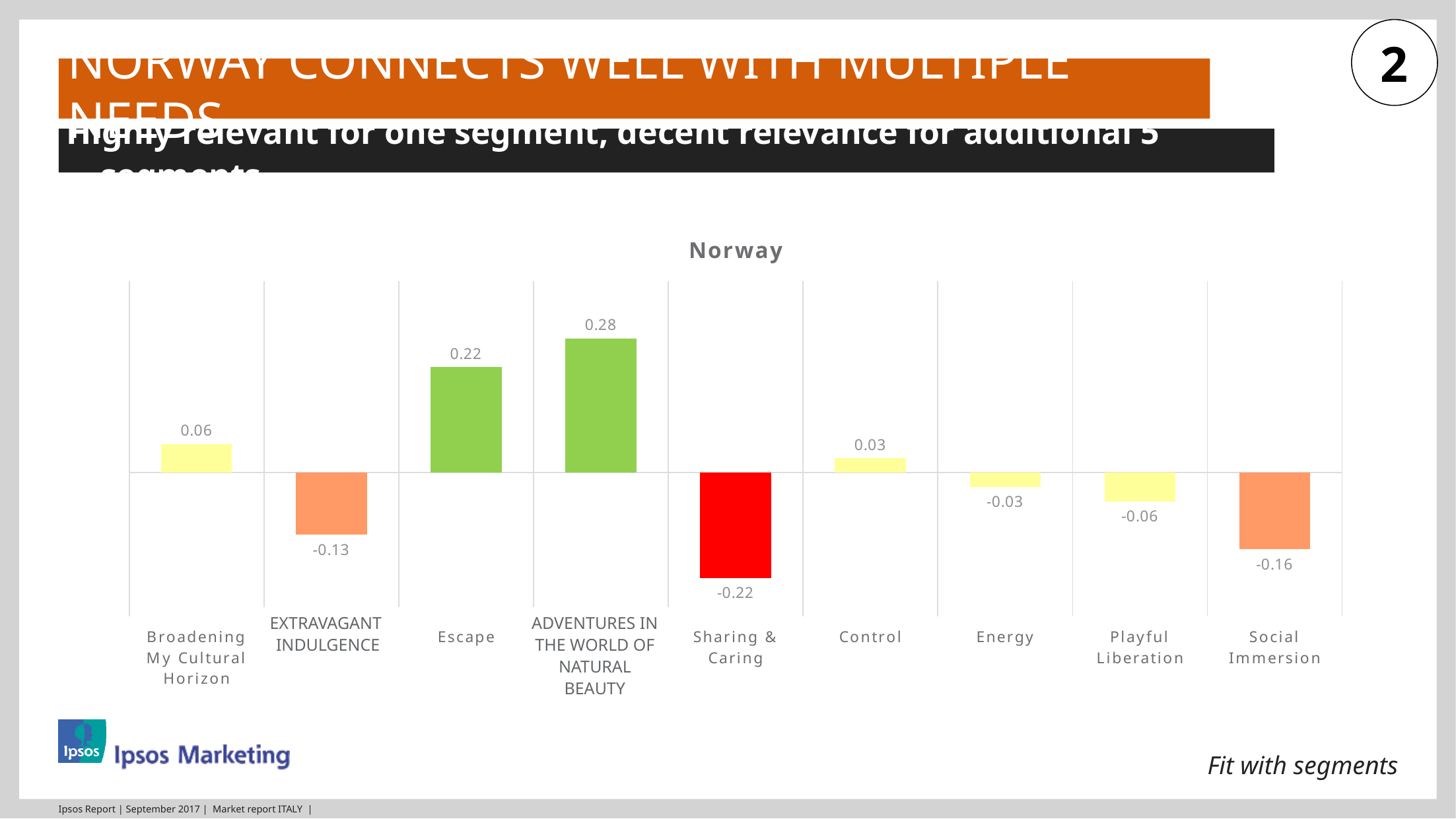
What is the difference between the values for Adventures in the World of Natural Beauty and Escape? 0.06 What is the value for Social Immersion? -0.16 What is the title of the chart? Norway Which is lower, the value for Extravagant Indulgence or the value for Social Immersion? Social Immersion What colour is the bar for Sharing & Caring? Red Which category has the lowest value? Sharing & Caring What is the value for Control? 0.03 Which is larger, the value for Broadening My Cultural Horizon or the value for Control? Broadening My Cultural Horizon What is the value for Escape? 0.22 What kind of chart is shown on the slide? Bar chart Which category has the highest value? Adventures in the World of Natural Beauty How many categories are shown on the chart? 9